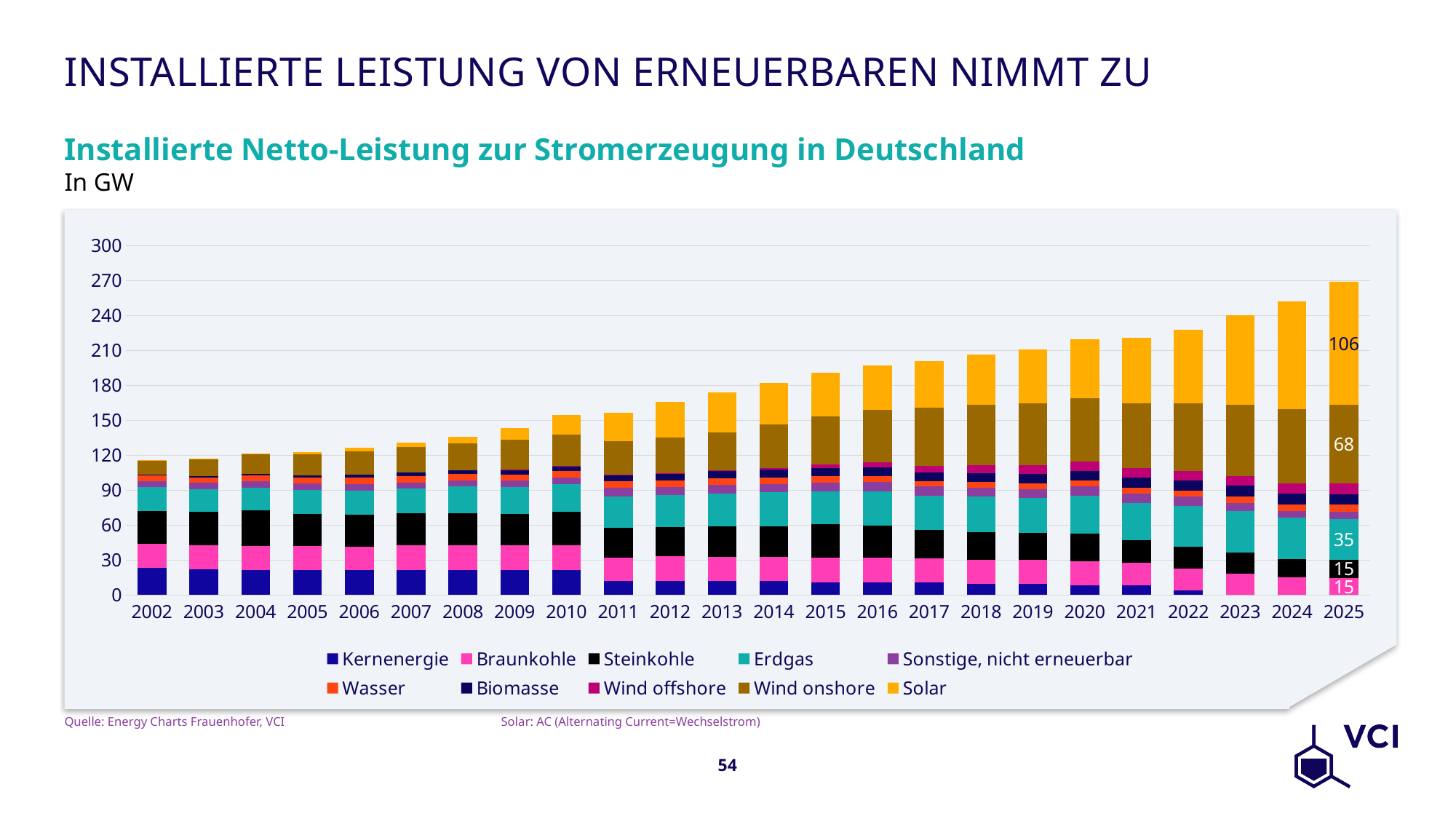
Is the total stacked value for 2025 greater or less than 240? greater In 2025, how much larger is the Solar segment than the Wind onshore segment? 38 How many years are shown on the x axis? 24 How many series does the legend list? 10 Is the total stacked value for 2002 greater or less than 150? less In 2025, which is larger: the Solar segment or the Wind onshore segment? Solar What is the value of the Steinkohle segment for 2025? 15 What is the value of the Solar segment for 2025? 106 Which year has the highest total installed capacity? 2025 What kind of chart is shown on the slide? Stacked bar chart What is the value of the Erdgas segment for 2025? 35 What is the value of the Wind onshore segment for 2025? 68